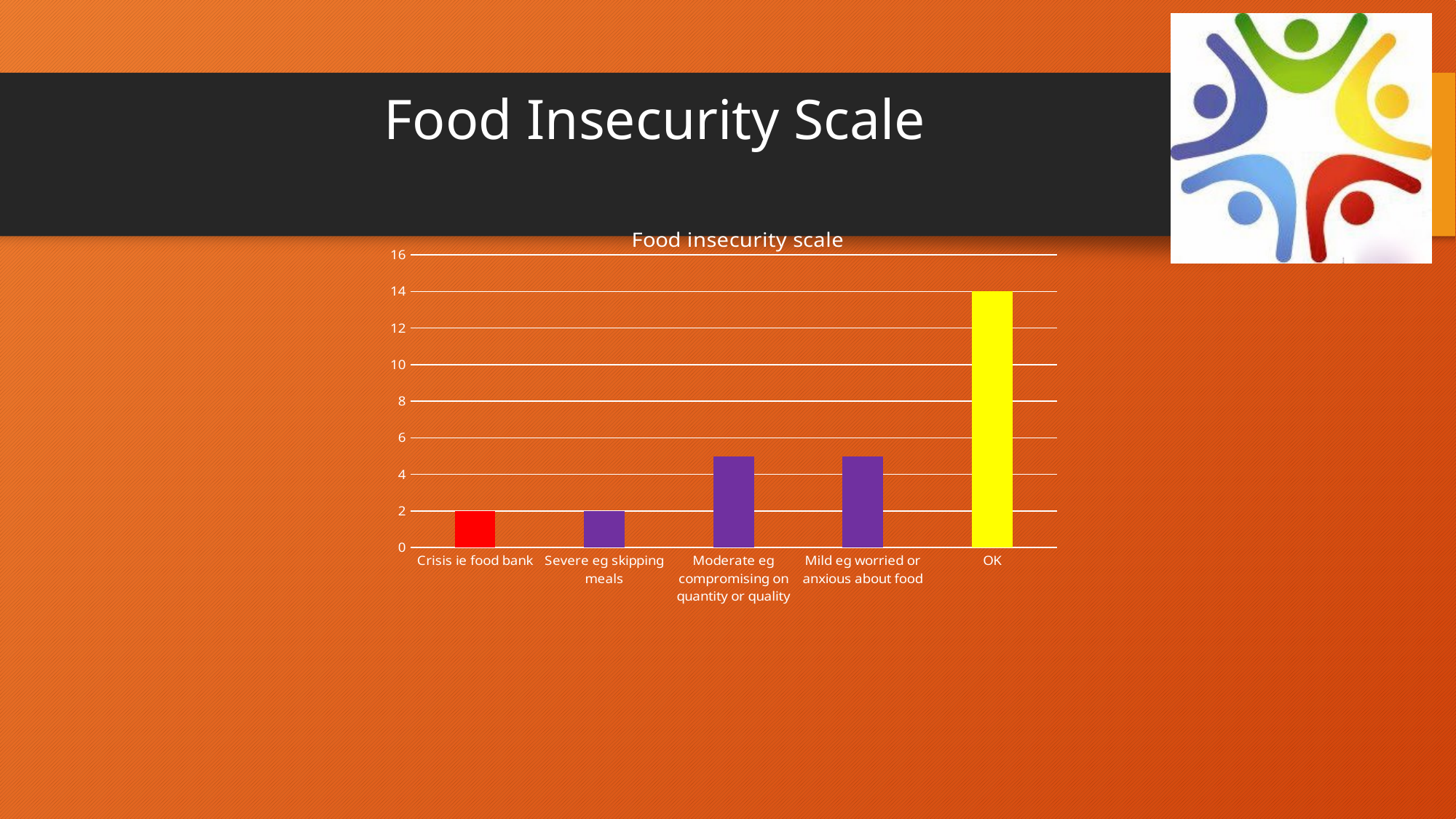
Which category has the highest value in the chart? OK Is the value for Mild eg worried or anxious about food greater or less than 6? less What is the title of the chart? Food insecurity scale What is the difference between the value for OK and the value for Crisis ie food bank? 12 What is the value for OK? 14 What kind of chart is shown on the slide? bar chart Which is larger, the value for OK or the value for Crisis ie food bank? OK How many categories are shown on the x axis of the chart? 5 Is the value for Moderate eg compromising on quantity or quality greater or less than 4? greater What is the value for Severe eg skipping meals? 2 What colour is the bar for OK? yellow What is the value for Crisis ie food bank? 2